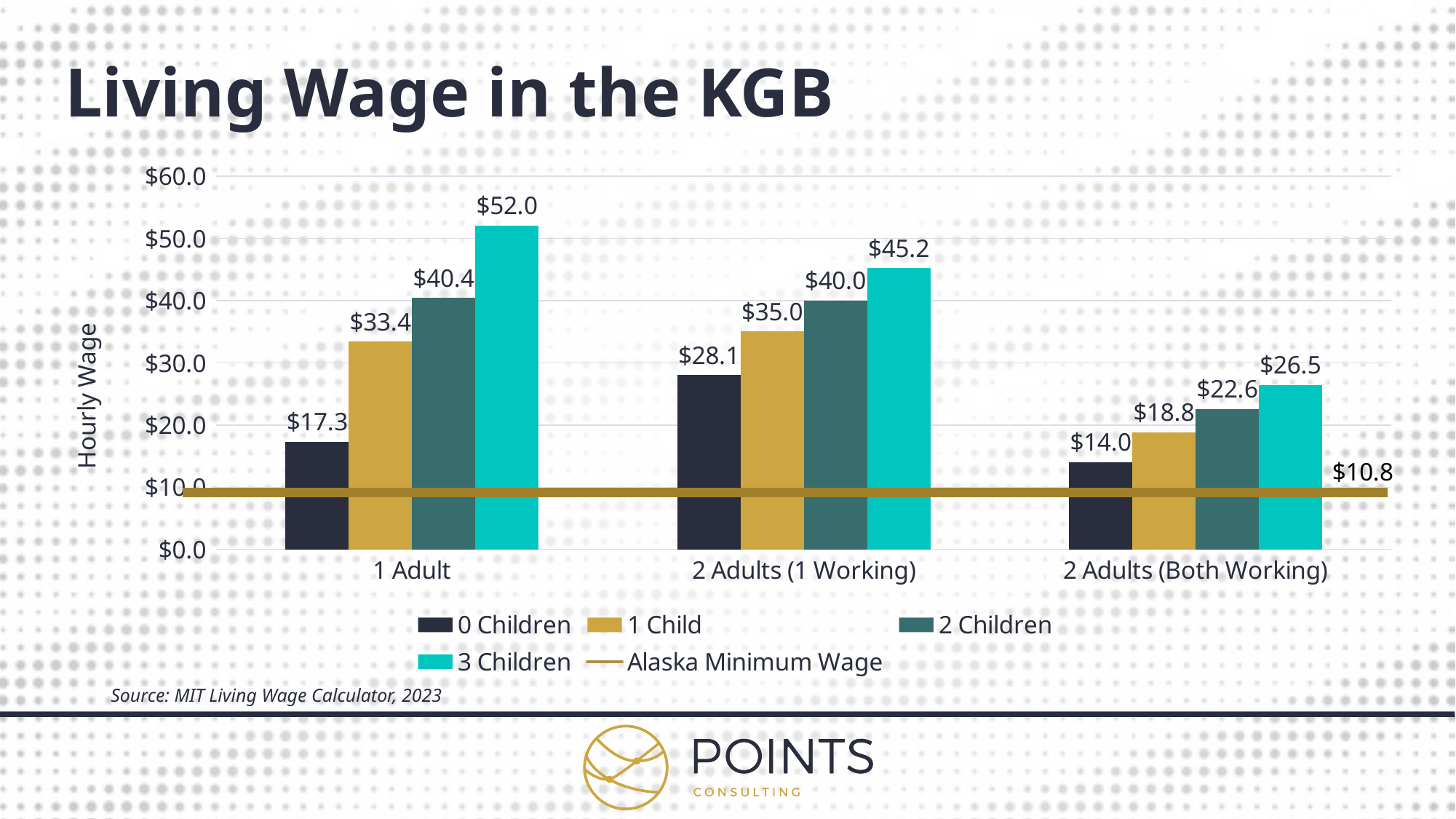
What is the living wage for 2 Adults (1 Working) with 1 Child? $35.0 What is the living wage for 2 Adults (Both Working) with 0 Children? $14.0 How many household categories are shown on the x axis? 3 How many entries does the legend list? 5 Which household category has the lowest living wage for 0 Children? 2 Adults (Both Working) What is the Alaska Minimum Wage shown on the chart? $10.8 What is the title of the chart? Living Wage in the KGB Which is larger: the 2 Children living wage for 1 Adult or for 2 Adults (1 Working)? 1 Adult What kind of chart is this? Bar chart Which household category has the highest living wage for 3 Children? 1 Adult What is the difference between the 3 Children and 0 Children living wage for 1 Adult? $34.7 What is the living wage for 1 Adult with 3 Children? $52.0